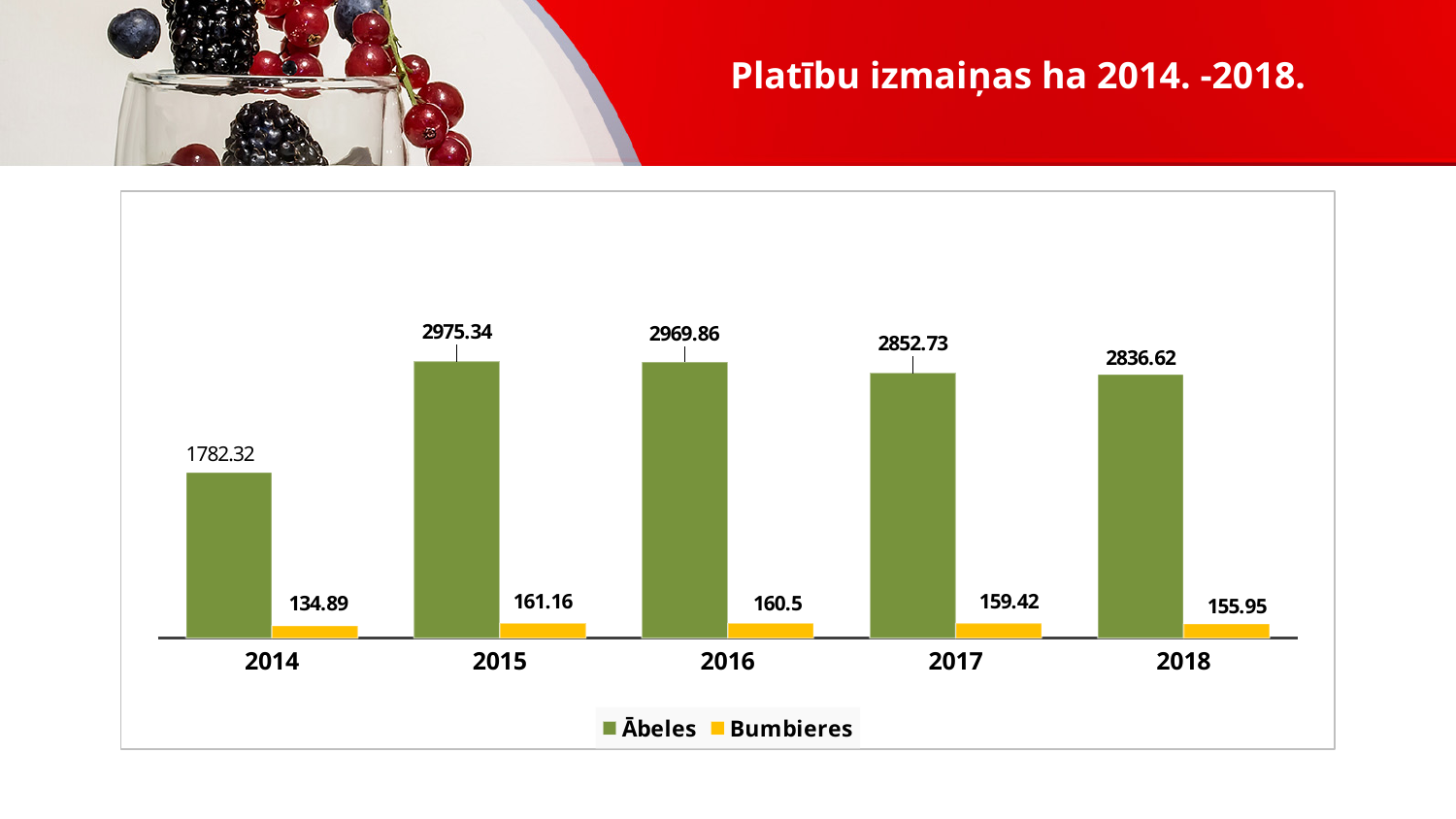
What is the value for Bumbieres in 2017? 159.42 How many years are shown on the x axis? 5 In which year is the Bumbieres value lowest? 2014 Do the Ābeles values rise or fall from 2015 to 2018? fall What is the difference between the Ābeles values for 2015 and 2014? 1193.02 How many series does the legend list? 2 Which is larger, the Ābeles value in 2017 or in 2018? 2017 What is the difference between the Bumbieres values for 2015 and 2014? 26.27 What is the value for Ābeles in 2018? 2836.62 What is the value for Ābeles in 2014? 1782.32 In which year is the Ābeles value highest? 2015 What kind of chart is shown on the slide? bar chart